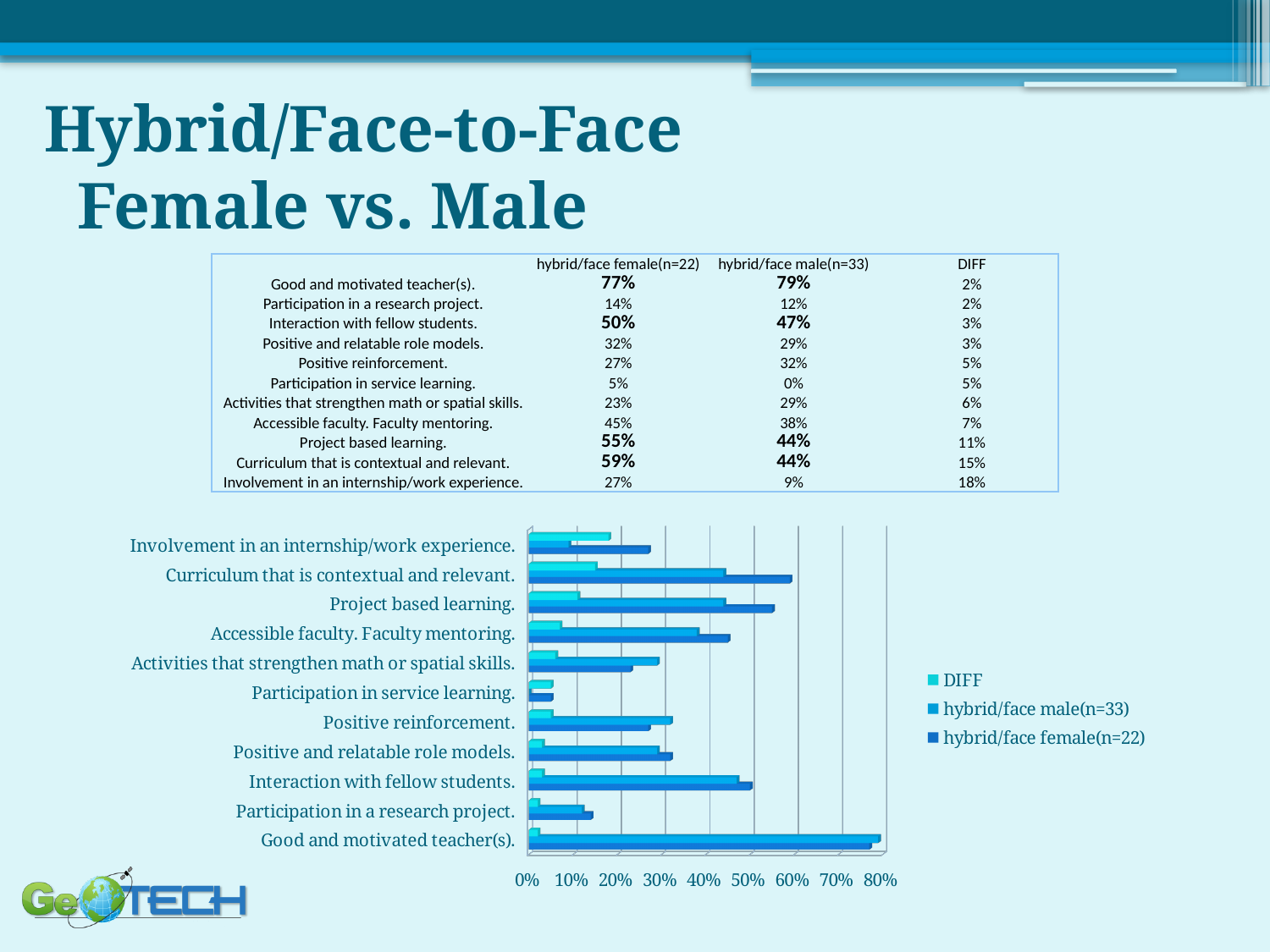
Which category has the lowest hybrid/face male(n=33) value? Participation in service learning. What is the hybrid/face female(n=22) value for 'Good and motivated teacher(s).'? 77% Is the hybrid/face female(n=22) value for 'Accessible faculty. Faculty mentoring.' greater or less than 40%? greater For 'Positive reinforcement.', which is larger: the hybrid/face female(n=22) value or the hybrid/face male(n=33) value? hybrid/face male(n=33) How many categories are plotted on the chart? 11 Which category has the highest hybrid/face female(n=22) value? Good and motivated teacher(s). What is the hybrid/face male(n=33) value for 'Involvement in an internship/work experience.'? 9% What is the difference between the hybrid/face female(n=22) and hybrid/face male(n=33) values for 'Project based learning.'? 11% Is the hybrid/face male(n=33) value for 'Project based learning.' greater or less than 50%? less How many series does the chart legend list? 3 Which category has the largest DIFF value? Involvement in an internship/work experience. What kind of chart is shown on the slide? bar chart